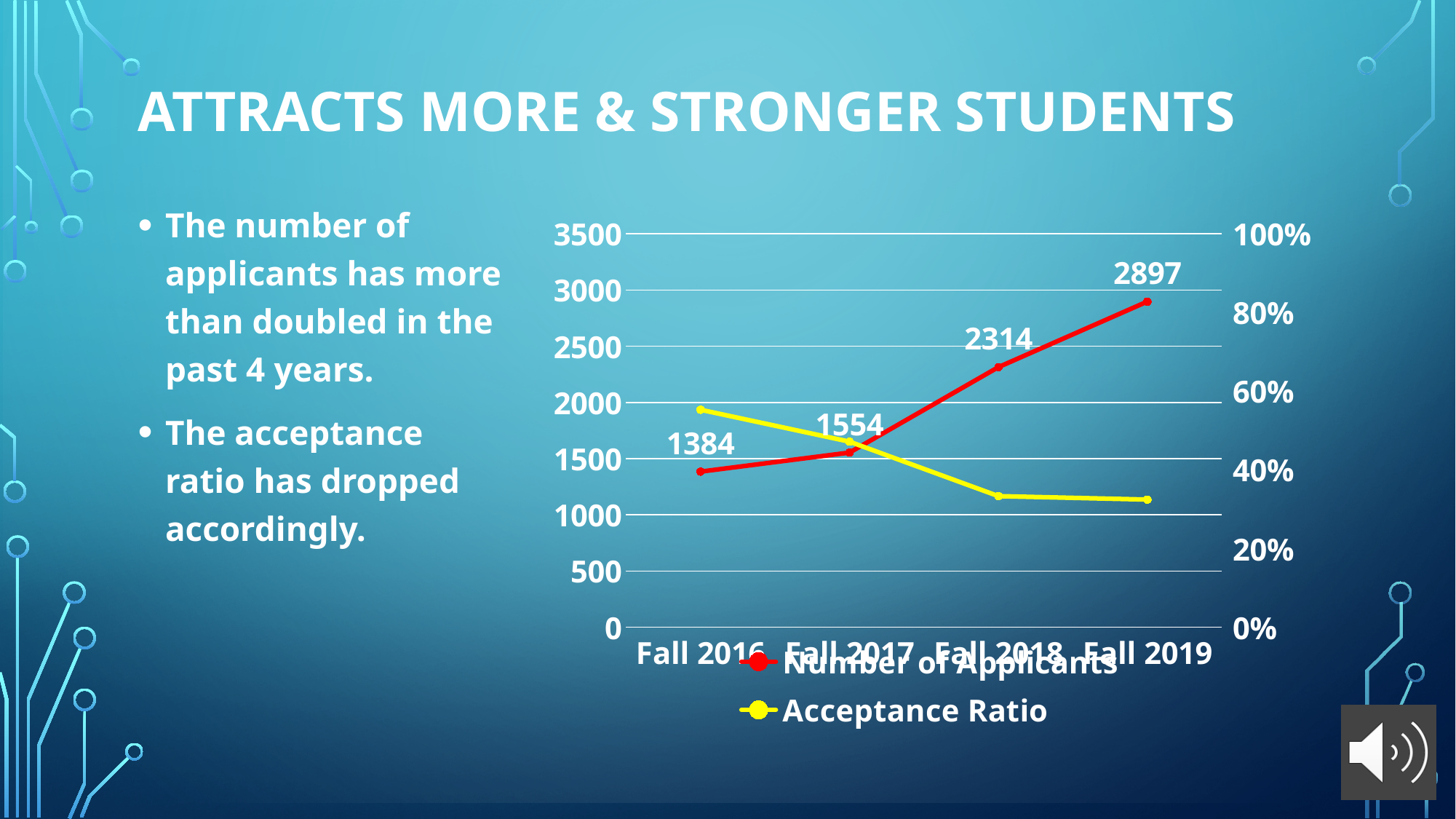
Does the Acceptance Ratio rise or fall from Fall 2016 to Fall 2019? fall What is the Number of Applicants for Fall 2019? 2897 Is the Acceptance Ratio for Fall 2016 greater or less than 40%? greater Which year has the lowest Number of Applicants? Fall 2016 What is the difference in Number of Applicants between Fall 2018 and Fall 2017? 760 What is the Number of Applicants for Fall 2016? 1384 How many series does the legend list? 2 Is the Acceptance Ratio for Fall 2018 greater or less than 40%? less Which year has the highest Number of Applicants? Fall 2019 What is the difference in Number of Applicants between Fall 2019 and Fall 2016? 1513 What is the Number of Applicants for Fall 2018? 2314 What kind of chart is shown on the slide? line chart